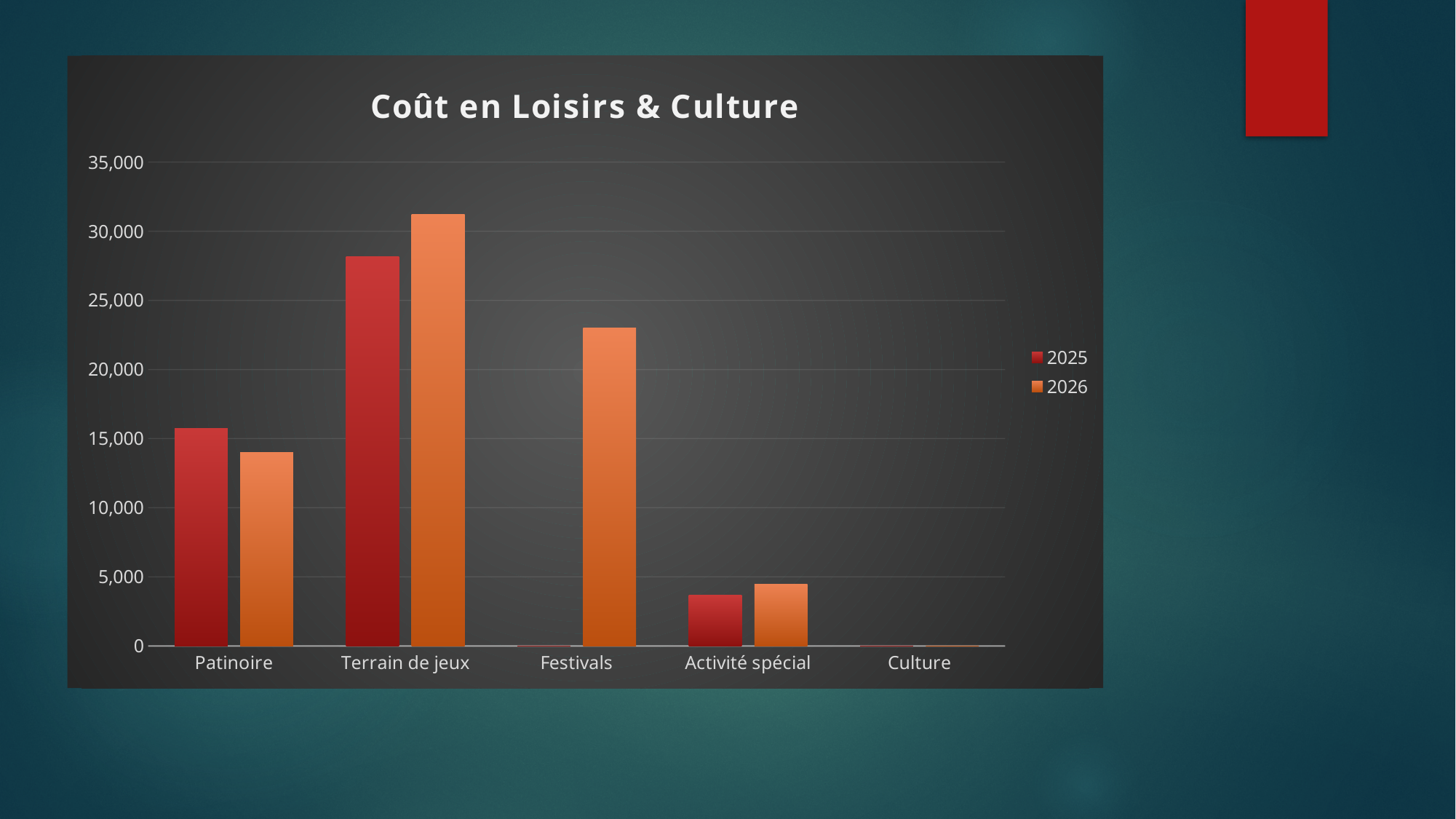
Is the 2026 value for Activité spécial greater or less than 5,000? less Which legend entry is shown in orange? 2026 What is the title of the chart? Coût en Loisirs & Culture What kind of chart is shown on the slide? bar chart For Patinoire, which series has the larger value, 2025 or 2026? 2025 How many categories are shown on the x axis? 5 How many series does the legend list? 2 Is the 2026 value for Festivals greater or less than 20,000? greater For Terrain de jeux, which series has the larger value, 2025 or 2026? 2026 Which category has the highest value for the 2026 series? Terrain de jeux Is the 2026 value for Terrain de jeux greater or less than 30,000? greater Which category has the highest value for the 2025 series? Terrain de jeux